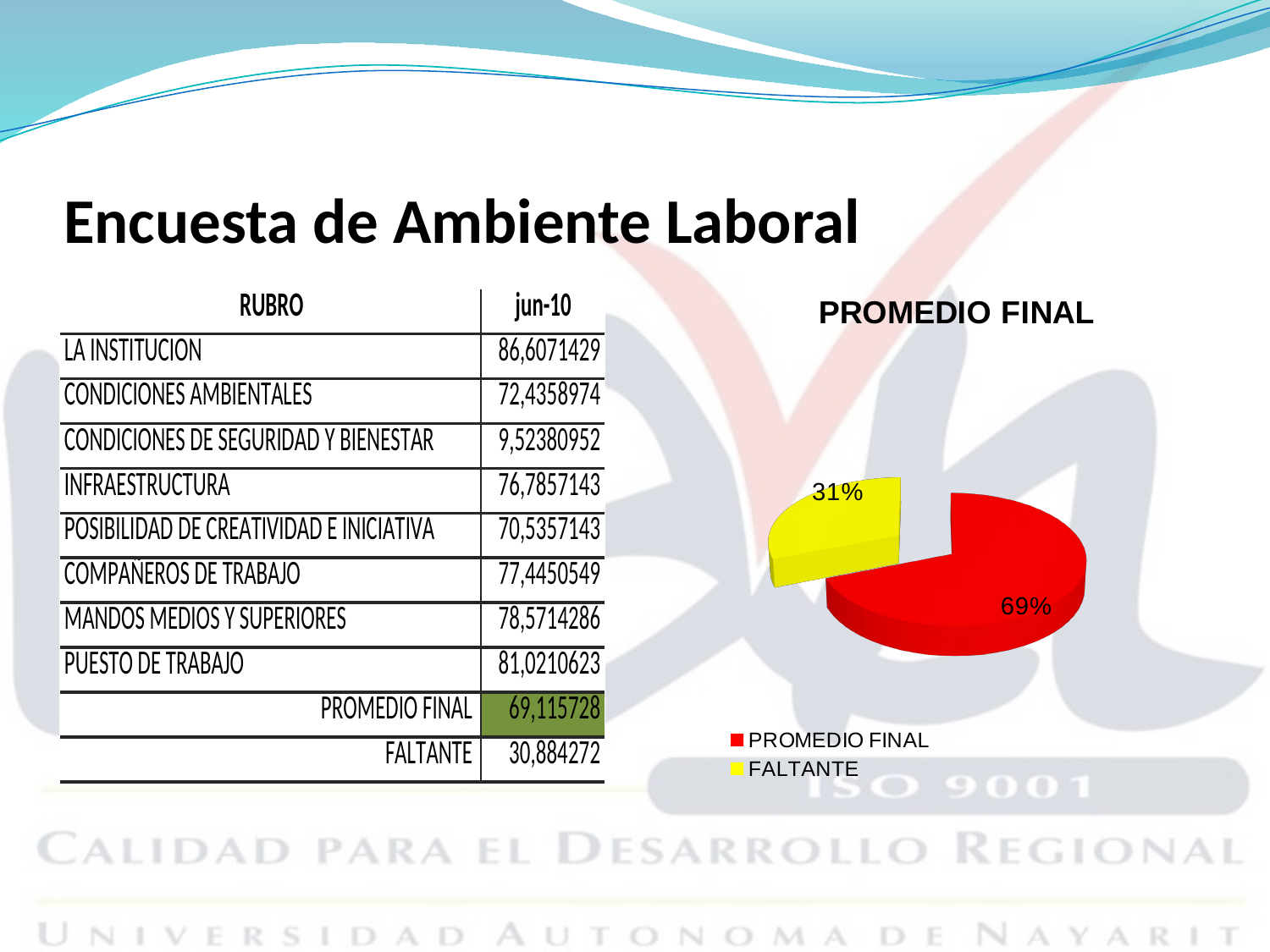
What share of the pie does PROMEDIO FINAL represent? 69% Which slice of the pie chart is the smallest? FALTANTE What is the difference in percentage points between the PROMEDIO FINAL slice and the FALTANTE slice? 38% What colour is the FALTANTE slice in the pie chart? yellow What kind of chart is shown on the slide? pie chart What share of the pie does FALTANTE represent? 31% What is the title of the chart? PROMEDIO FINAL Which is larger in the pie chart, PROMEDIO FINAL or FALTANTE? PROMEDIO FINAL How many slices does the pie chart have? 2 Which slice of the pie chart is the largest? PROMEDIO FINAL How many entries does the chart legend list? 2